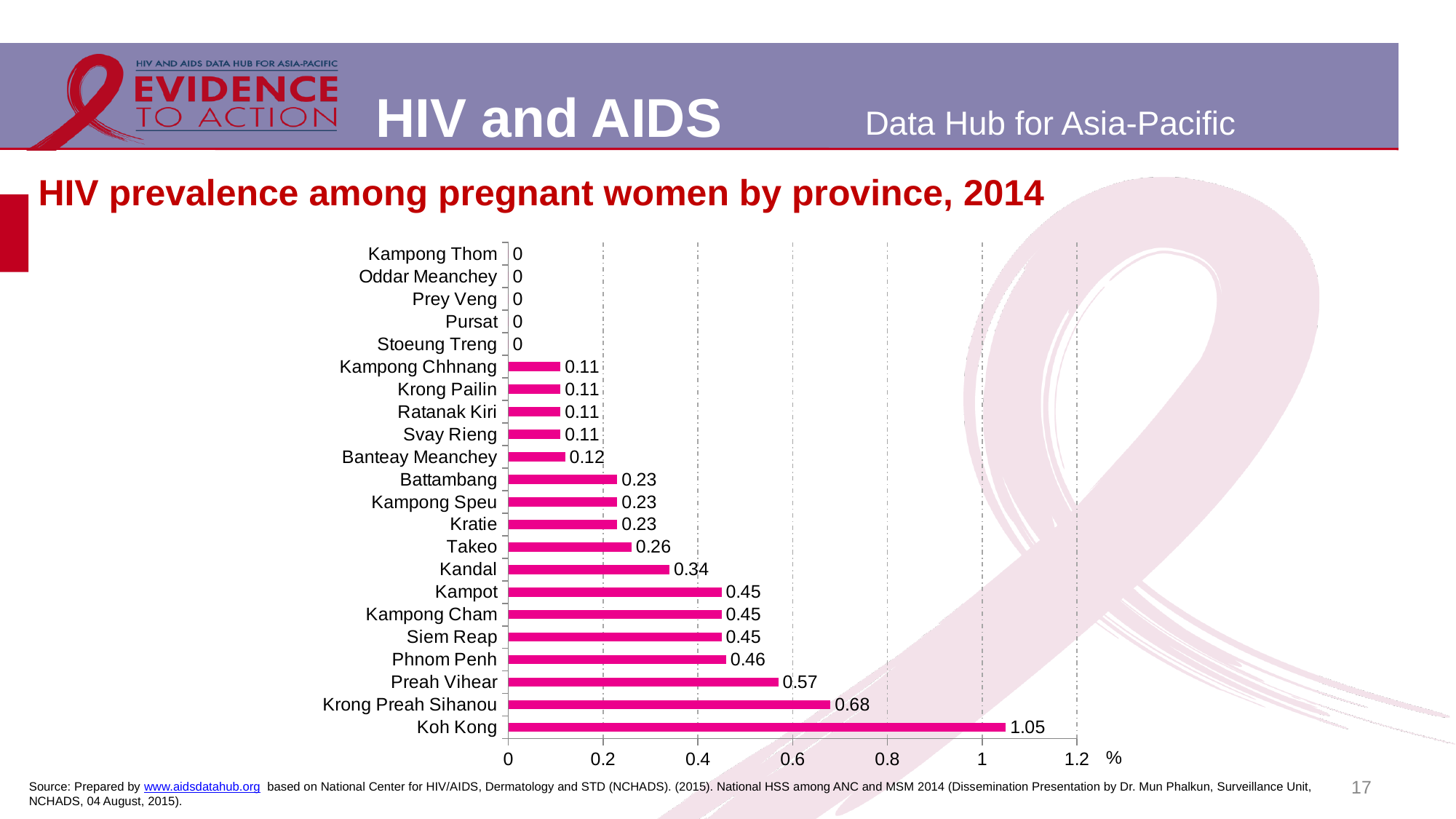
What type of chart is used on the slide? Bar chart What is the difference in HIV prevalence between Preah Vihear and Takeo? 0.31 Is the value for Krong Preah Sihanou greater or less than 0.6? greater What is the HIV prevalence among pregnant women in Kandal? 0.34 What is the difference in HIV prevalence between Koh Kong and Krong Preah Sihanou? 0.37 What is the HIV prevalence among pregnant women in Phnom Penh? 0.46 What is the HIV prevalence among pregnant women in Koh Kong? 1.05 What is the title of the chart? HIV prevalence among pregnant women by province, 2014 How many provinces have an HIV prevalence of 0? 5 Which has a higher HIV prevalence, Kampot or Banteay Meanchey? Kampot How many provinces are shown in the chart? 22 Which province has the highest HIV prevalence among pregnant women? Koh Kong